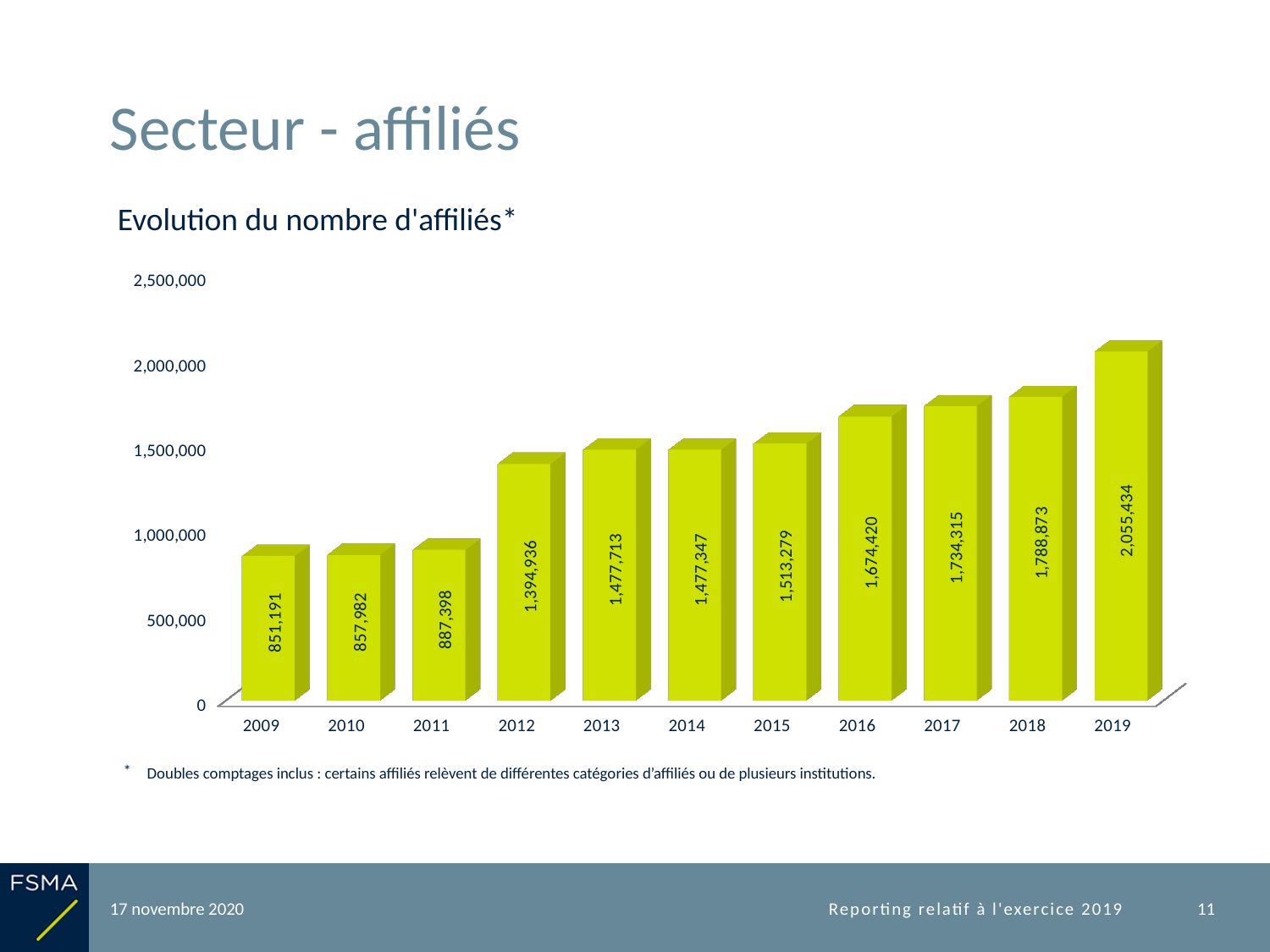
Which year has the highest value? 2019 Which year has the lowest value? 2009 Do the values generally rise or fall from 2009 to 2019? rise What is the value for 2012? 1,394,936 What is the difference between the values for 2019 and 2018? 266,561 What kind of chart is this? bar chart What is the value for 2016? 1,674,420 Is the value for 2019 greater or less than 2,000,000? greater What is the value for 2019? 2,055,434 Which is larger, the value for 2015 or the value for 2016? 2016 How many years are shown on the x axis? 11 What is the difference between the values for 2012 and 2011? 507,538